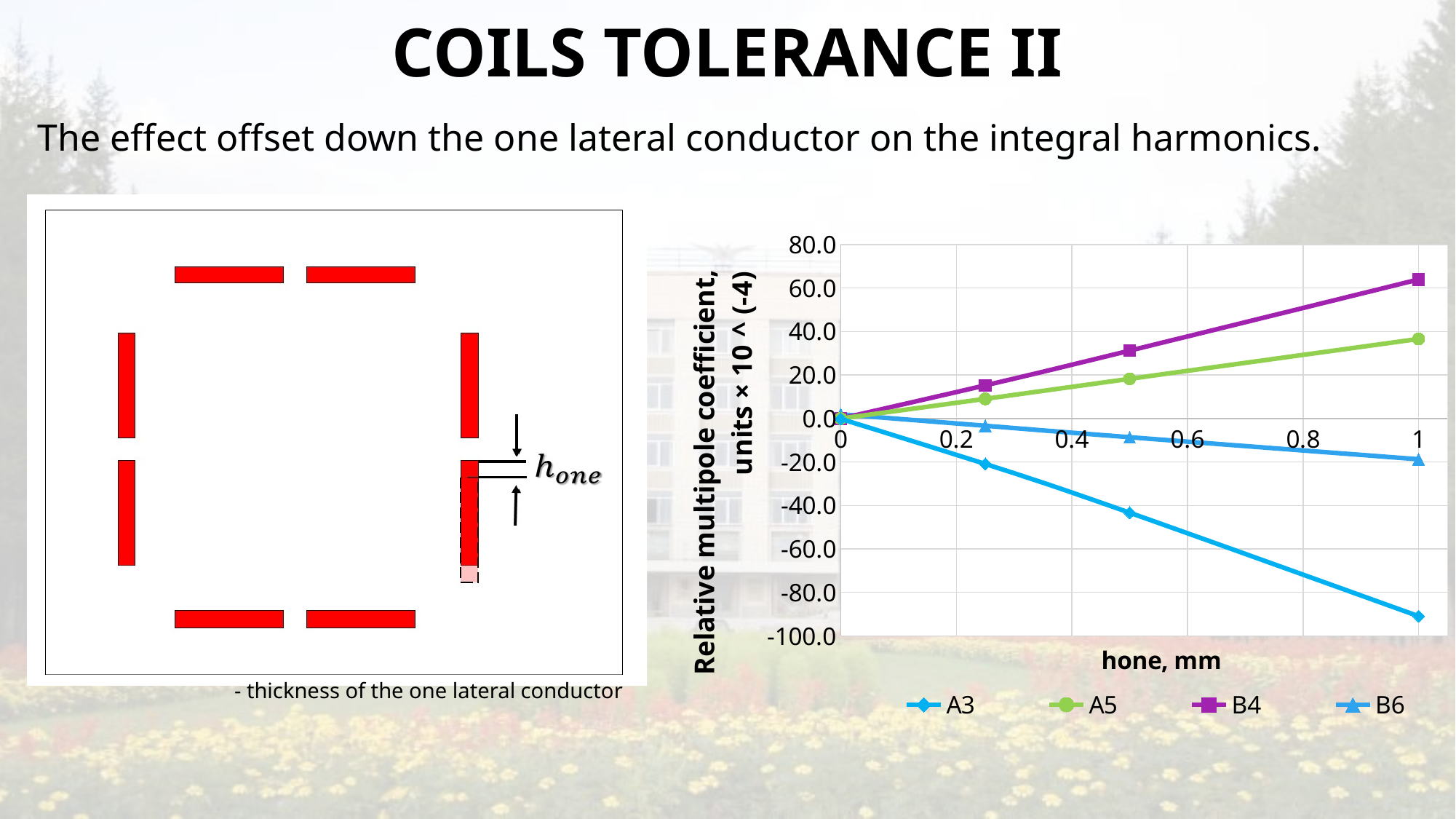
Is the value of B6 at hone = 1 mm greater or less than 0.0? less How many series does the chart legend list? 4 At hone = 1 mm, which series has the larger value, A5 or B6? A5 Which series has the highest value at hone = 1 mm? B4 Which series are listed in the chart legend? A3, A5, B4, B6 What kind of chart is shown on the slide? line chart Is the value of B4 at hone = 1 mm greater or less than 40.0? greater Does the B4 series rise or fall as hone increases? rises Which series has the lowest value at hone = 1 mm? A3 Does the A3 series rise or fall as hone increases? falls What is the x-axis title of the chart? hone, mm Is the value of A3 at hone = 1 mm greater or less than -80.0? less